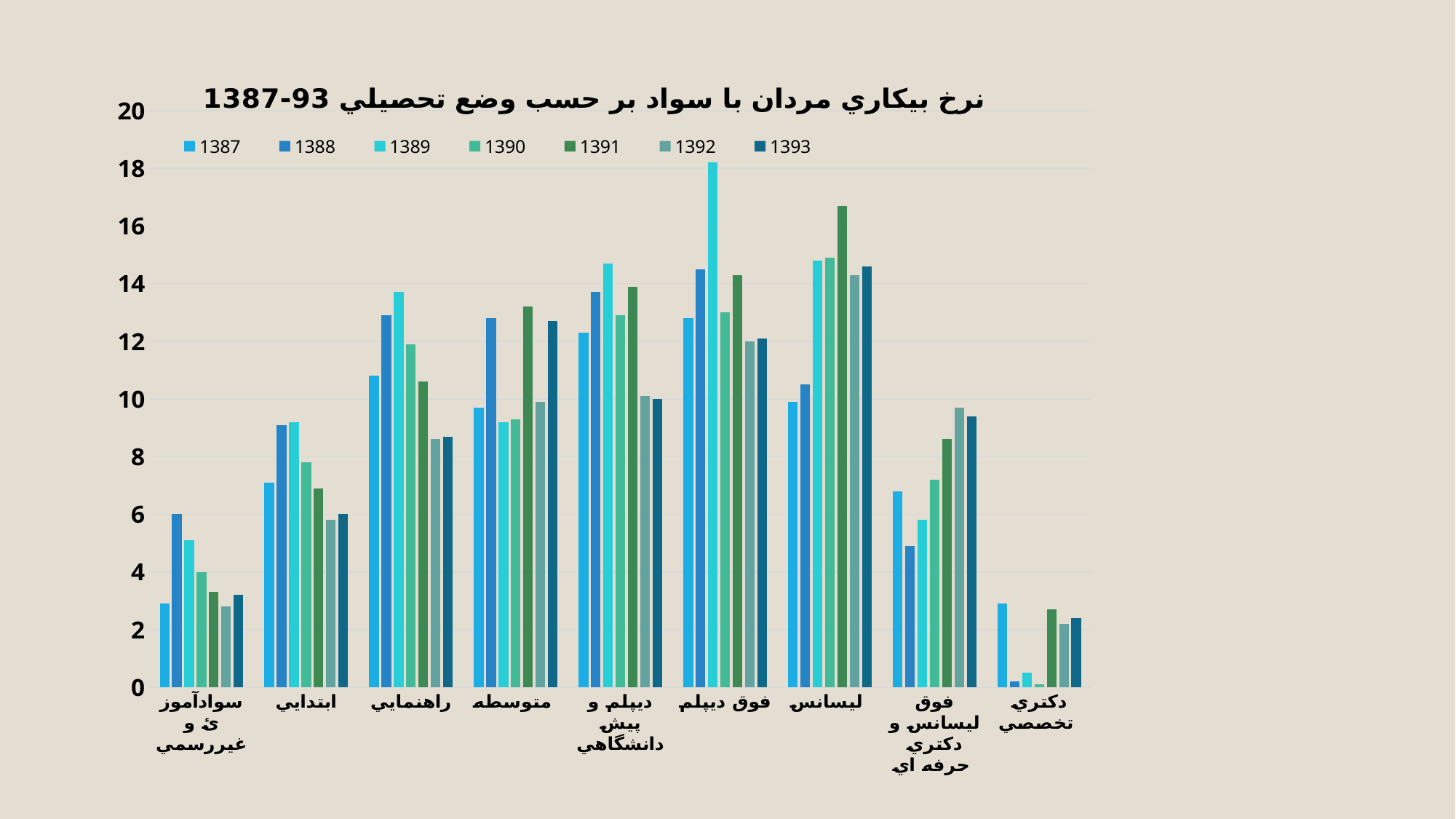
In the متوسطه category, which is larger, the value for 1391 or for 1392? 1391 Is the value for 1387 in the ابتدايي category greater or less than 8? less How many education-level categories are shown on the x axis? 9 What is the title of the chart? نرخ بيكاري مردان با سواد بر حسب وضع تحصيلي 1387-93 Which category has the highest value for the 1391 series? ليسانس Is the value for 1389 in the فوق ديپلم category greater or less than 16? greater What kind of chart is shown on the slide? bar chart Is the value for 1388 in the راهنمايي category greater or less than 12? greater Which category has the lowest value for the 1389 series? دكتري تخصصي In the سوادآموزي و غيررسمي category, which is larger, the value for 1387 or for 1388? 1388 Which year has the highest bar in the فوق ديپلم category? 1389 How many series does the legend list? 7